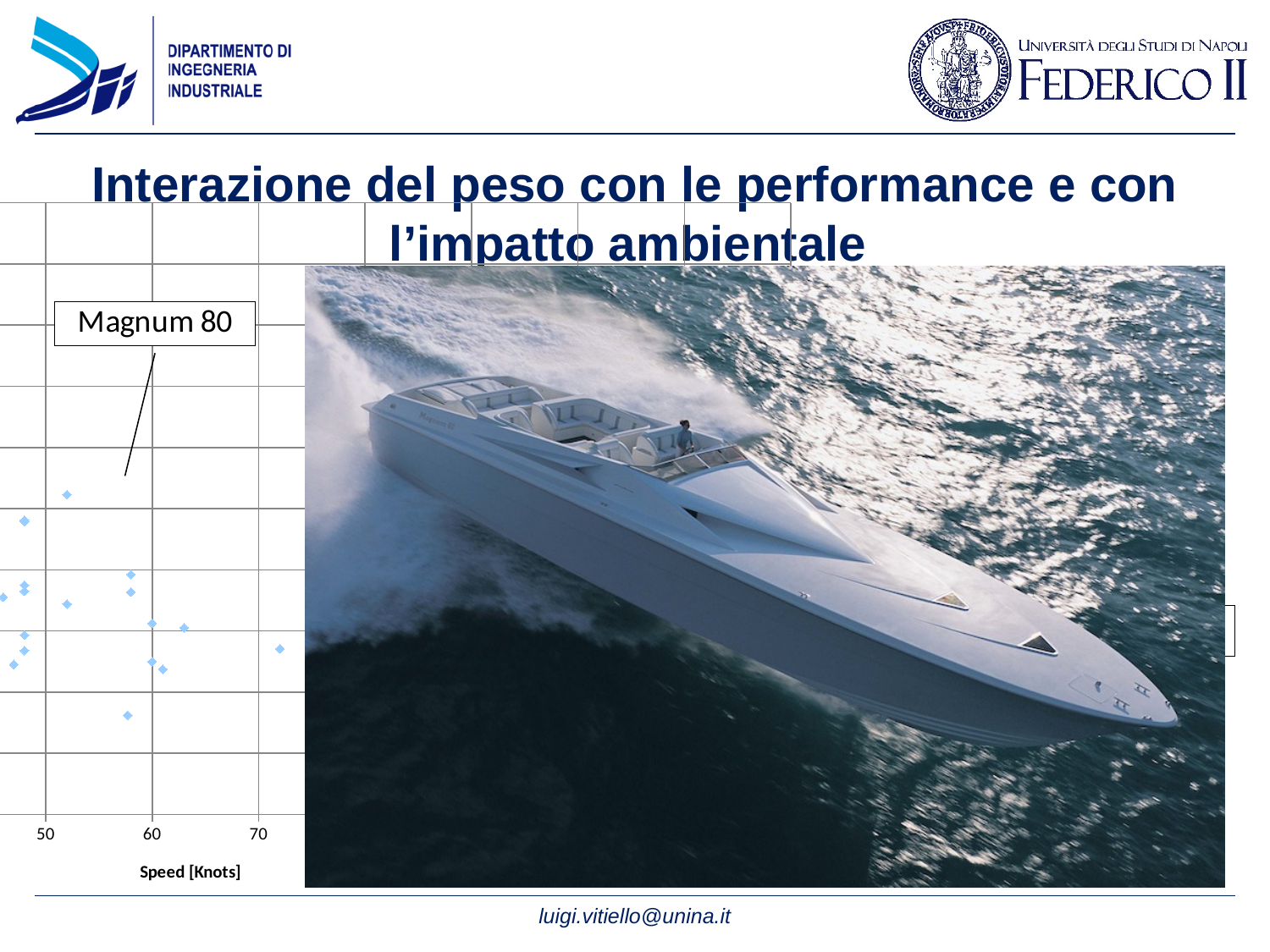
Which boat is named in the annotation label on the chart? Magnum 80 What kind of chart is shown on the left of the slide? scatter chart Is the speed of the point labelled Magnum 80 greater or less than 70 knots? less What is the title of the x axis of the chart? Speed [Knots]